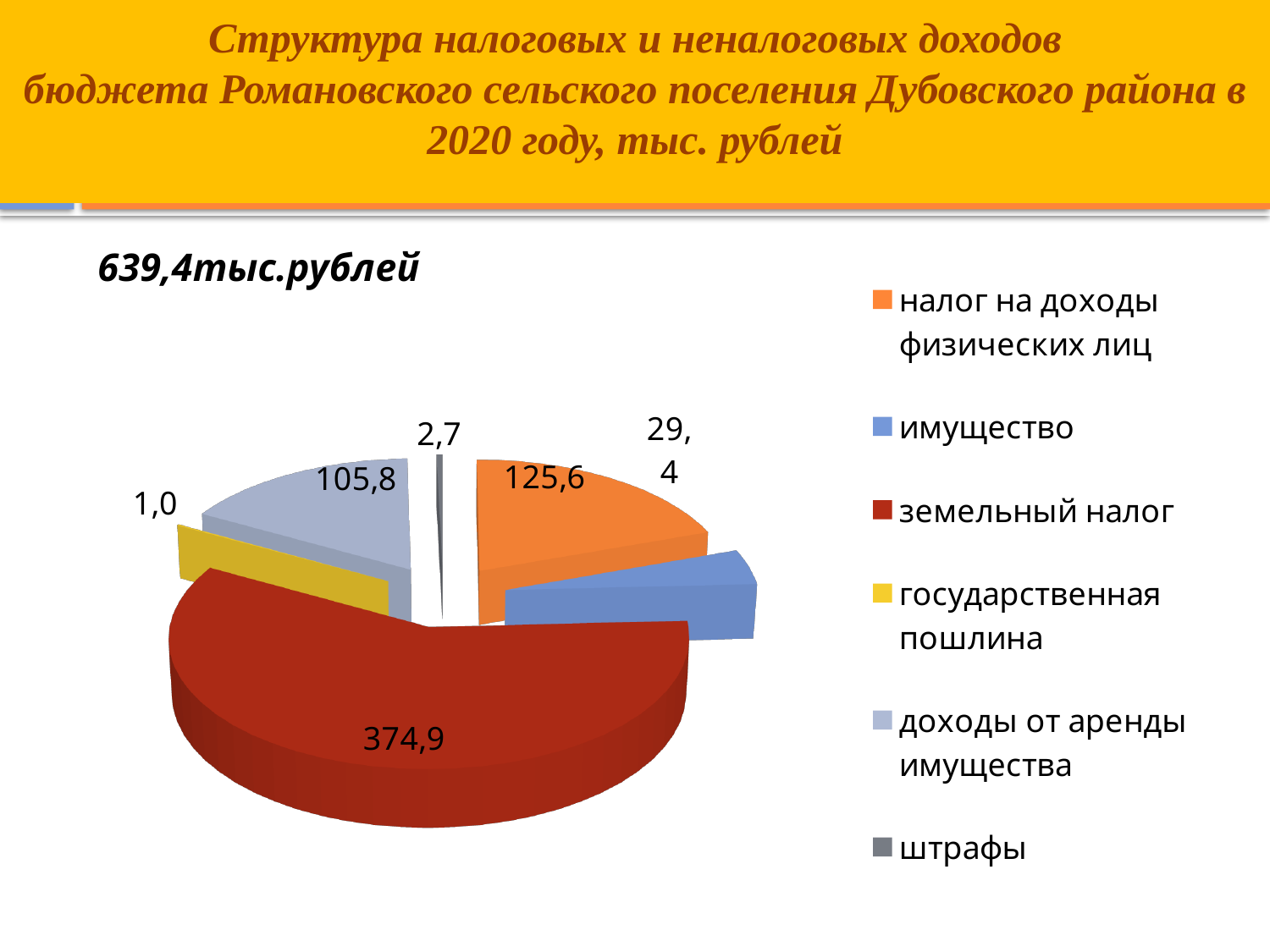
How many categories does the pie chart show? 6 What is the value for земельный налог in the pie chart? 374,9 Which category has the largest slice of the pie? земельный налог What is the value for налог на доходы физических лиц? 125,6 Which category has the smallest slice of the pie? государственная пошлина Which is larger, налог на доходы физических лиц or доходы от аренды имущества? налог на доходы физических лиц What is the value for имущество? 29,4 What is the value for доходы от аренды имущества? 105,8 What is the value for штрафы? 2,7 What total amount in thousand rubles is stated above the pie chart? 639,4тыс.рублей What type of chart is shown on the slide? pie chart What is the difference between земельный налог and налог на доходы физических лиц? 249,3